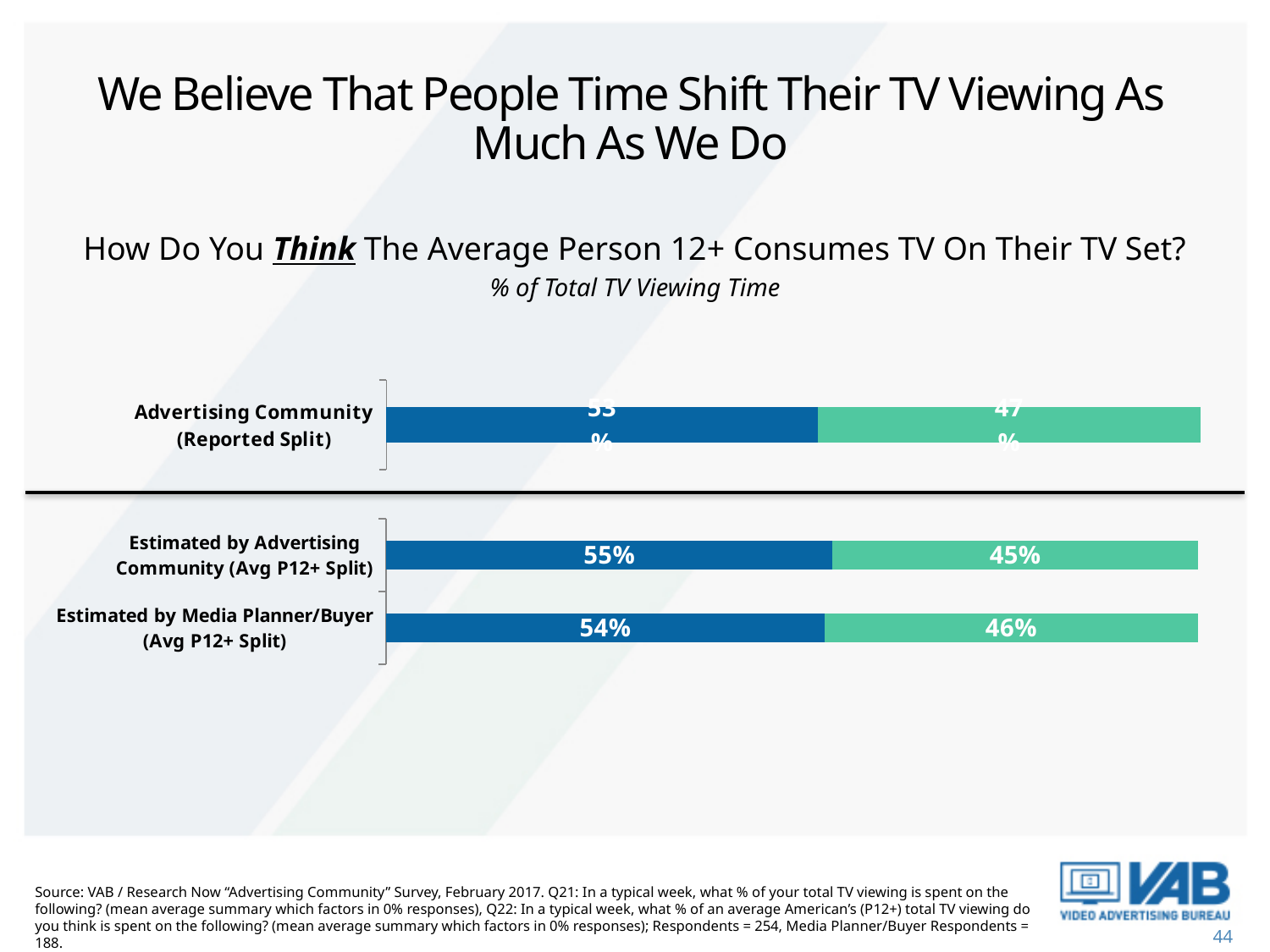
In the bottom chart, what is the difference between the blue and green segments for 'Estimated by Media Planner/Buyer (Avg P12+ Split)'? 8% In the bottom chart, what is the value of the blue segment for 'Estimated by Advertising Community (Avg P12+ Split)'? 55% What kind of chart is used on this slide? Stacked bar chart In the bottom chart, what is the value of the green segment for 'Estimated by Advertising Community (Avg P12+ Split)'? 45% In the bottom chart, which category has the larger blue segment: 'Estimated by Advertising Community (Avg P12+ Split)' or 'Estimated by Media Planner/Buyer (Avg P12+ Split)'? Estimated by Advertising Community (Avg P12+ Split) In the bottom chart, what is the value of the blue segment for 'Estimated by Media Planner/Buyer (Avg P12+ Split)'? 54% In the top chart, what is the value of the green segment for 'Advertising Community (Reported Split)'? 47% In the top chart, what is the value of the blue segment for 'Advertising Community (Reported Split)'? 53% In the bottom chart, what is the total of the stacked bar for 'Estimated by Media Planner/Buyer (Avg P12+ Split)'? 100% In the bottom chart, what is the difference between the blue and green segments for 'Estimated by Advertising Community (Avg P12+ Split)'? 10% How many categories are shown in the bottom chart? 2 In the bottom chart, what is the value of the green segment for 'Estimated by Media Planner/Buyer (Avg P12+ Split)'? 46%